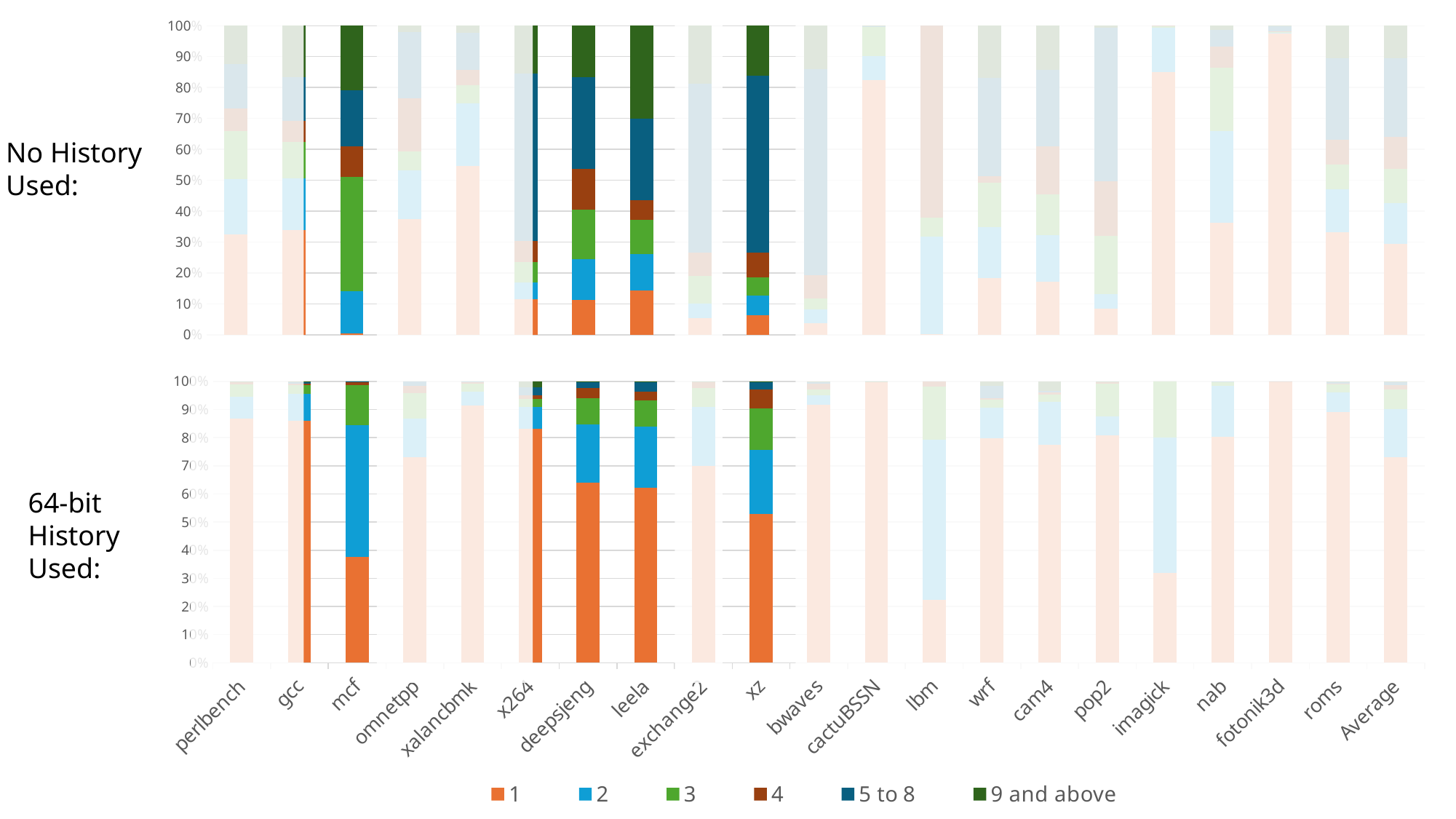
How many categories are shown along the x axis? 21 In the 64-bit History Used chart, is the value of the '1' segment for mcf greater or less than 40%? less In the 64-bit History Used chart, is the value of the '1' segment for lbm greater or less than 30%? less In the No History Used chart, is the value of the '1' segment for xz greater or less than 10%? less In the No History Used chart, what is the total of the stacked bar for mcf? 100% In the No History Used chart, which has the larger '9 and above' segment, leela or deepsjeng? leela What kind of chart is shown on the slide? stacked bar chart How many series does the legend list? 6 What is the last entry in the legend? 9 and above In the 64-bit History Used chart, which has the larger '1' segment, mcf or xz? xz